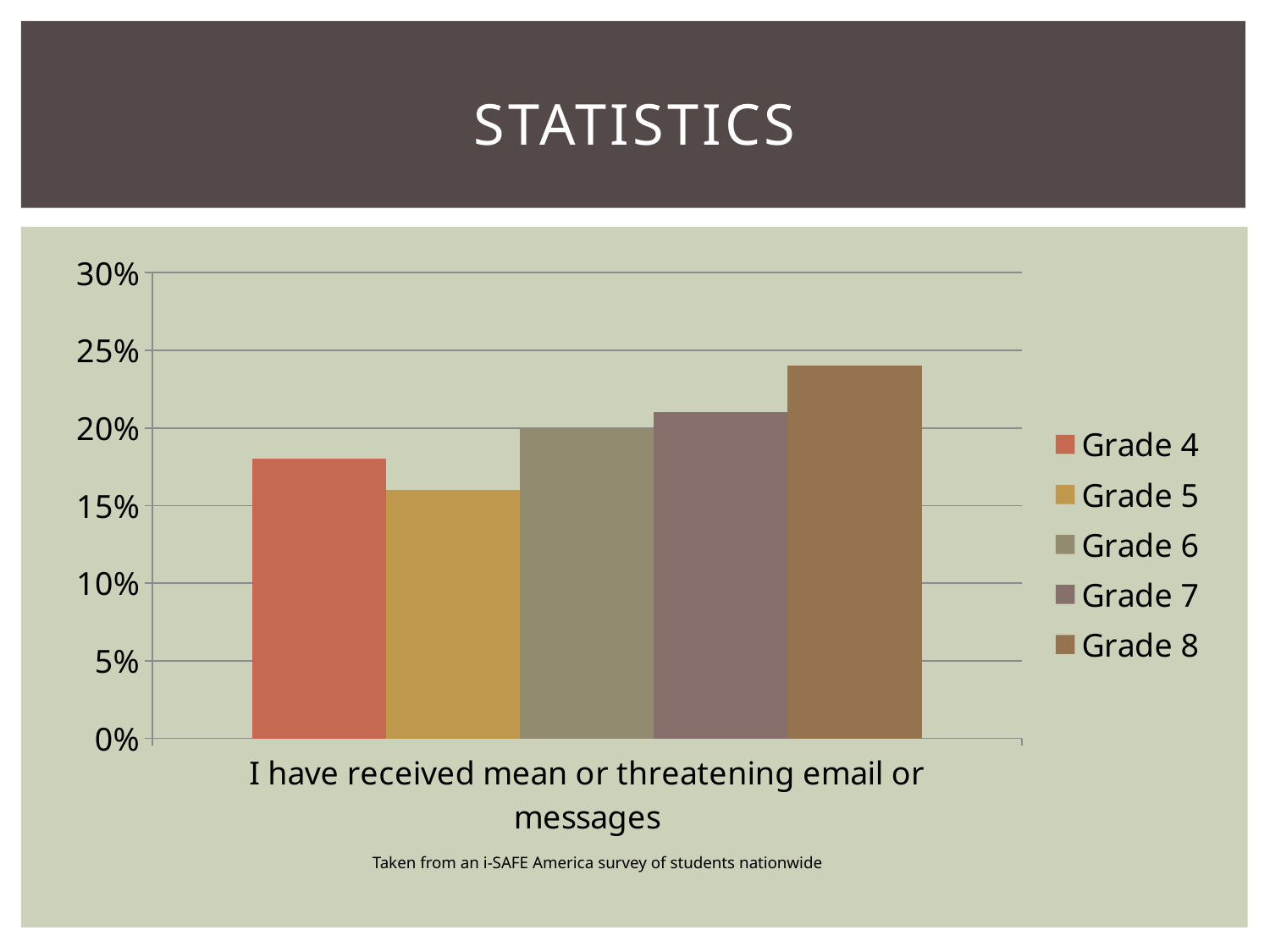
How many series does the legend list? 5 Which is larger, the value for Grade 6 or the value for Grade 8? Grade 8 Which grade has the lowest value for receiving mean or threatening email or messages? Grade 5 What kind of chart is shown on the slide? bar chart Is the value for Grade 8 greater or less than 25%? less Is the value for Grade 4 greater or less than 15%? greater Is the value for Grade 5 greater or less than 20%? less Which grade has the highest value for receiving mean or threatening email or messages? Grade 8 Which is larger, the value for Grade 4 or the value for Grade 5? Grade 4 What is the category label shown under the bars? I have received mean or threatening email or messages What is the value for Grade 6? 20%